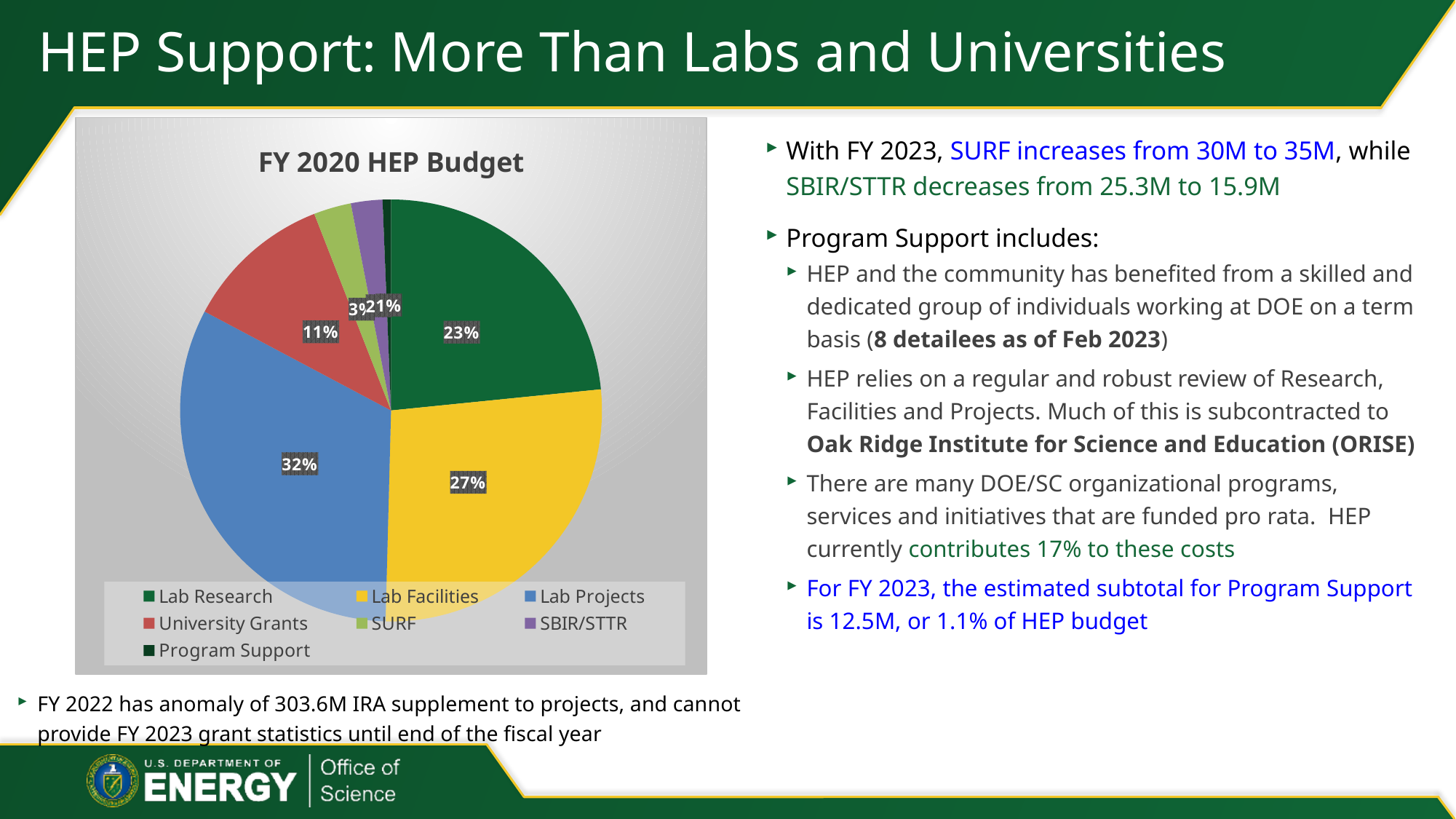
What share of the FY 2020 HEP Budget goes to Lab Research? 23% What share of the FY 2020 HEP Budget goes to Lab Facilities? 27% By how many percentage points does the Lab Projects share exceed the Lab Facilities share? 5 percentage points What share of the FY 2020 HEP Budget goes to Lab Projects? 32% What share of the FY 2020 HEP Budget goes to University Grants? 11% How many categories does the legend of the pie chart list? 7 By how many percentage points does the Lab Research share exceed the University Grants share? 12 percentage points Which is larger in the FY 2020 HEP Budget pie: Lab Research or University Grants? Lab Research Which category has the largest slice of the FY 2020 HEP Budget pie? Lab Projects What colour is the Lab Facilities slice in the pie chart? Yellow What kind of chart is shown on the slide? Pie chart What is the title of the pie chart? FY 2020 HEP Budget